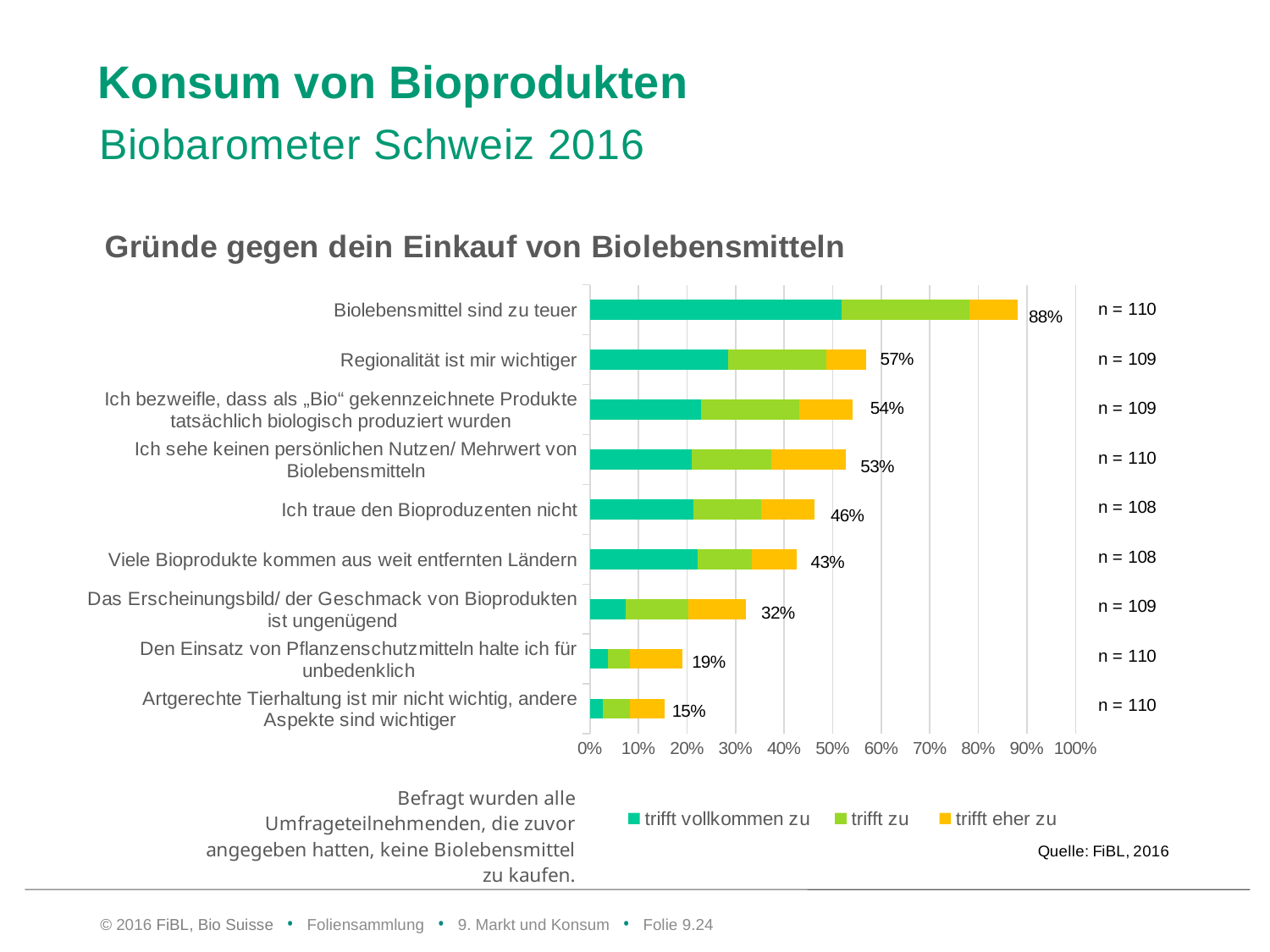
How many reasons (categories) are shown in the chart? 9 What kind of chart is shown on the slide? Stacked bar chart What is the total percentage shown for "Biolebensmittel sind zu teuer"? 88% What is the total percentage shown for "Artgerechte Tierhaltung ist mir nicht wichtig, andere Aspekte sind wichtiger"? 15% Which has a higher total: "Viele Bioprodukte kommen aus weit entfernten Ländern" or "Das Erscheinungsbild/ der Geschmack von Bioprodukten ist ungenügend"? Viele Bioprodukte kommen aus weit entfernten Ländern Which reason has the lowest total percentage? Artgerechte Tierhaltung ist mir nicht wichtig, andere Aspekte sind wichtiger What is the total percentage shown for "Regionalität ist mir wichtiger"? 57% Which reason has the highest total percentage? Biolebensmittel sind zu teuer Is the "trifft vollkommen zu" value for "Biolebensmittel sind zu teuer" greater or less than 40%? greater What is the total percentage shown for "Ich traue den Bioproduzenten nicht"? 46% How many series does the legend list? 3 What is the difference in percentage points between the totals for "Biolebensmittel sind zu teuer" and "Regionalität ist mir wichtiger"? 31 percentage points